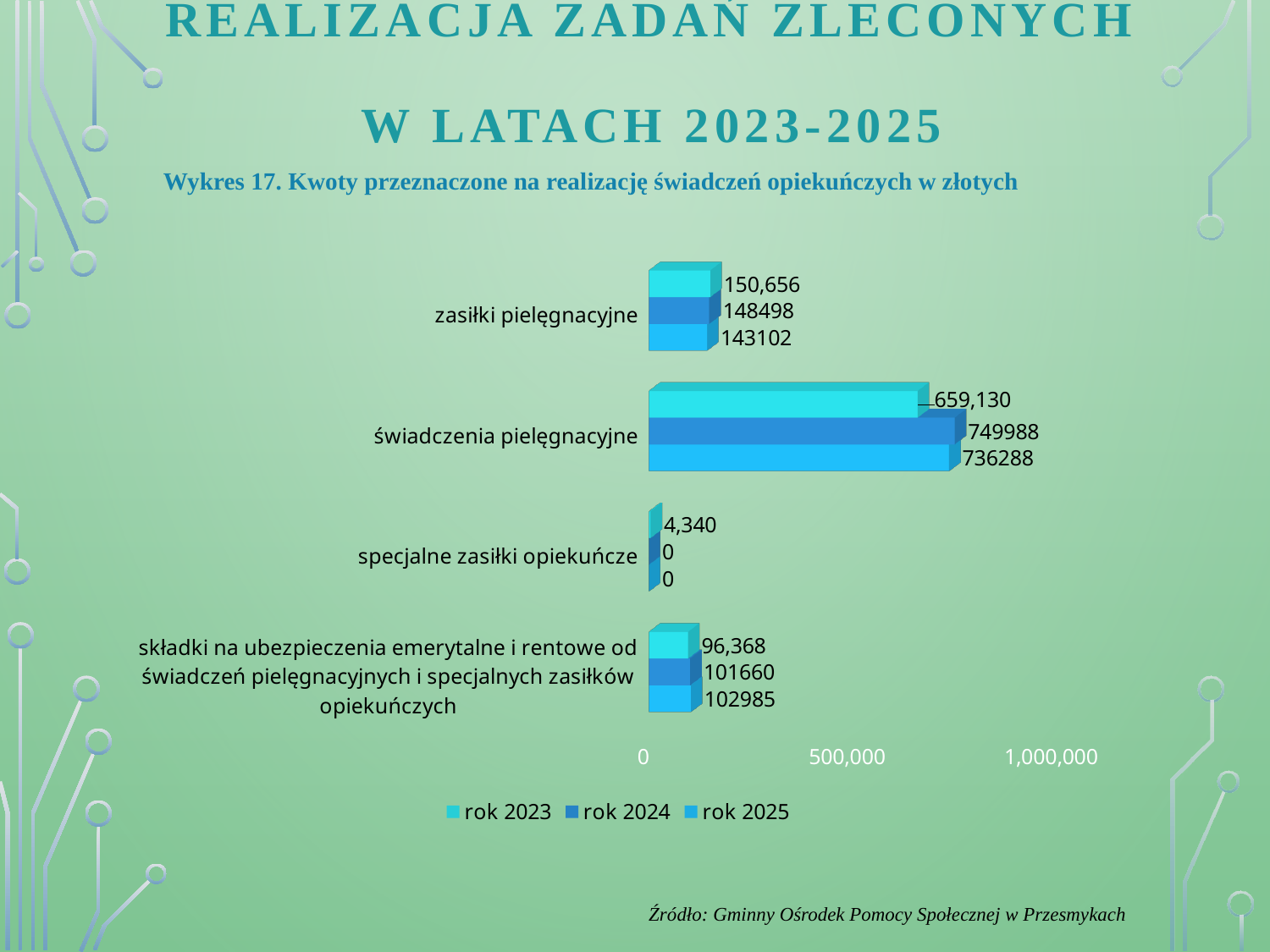
How many series does the legend list? 3 Which category has the lowest value in rok 2024? specjalne zasiłki opiekuńcze What is the title of the chart? Wykres 17. Kwoty przeznaczone na realizację świadczeń opiekuńczych w złotych Which is larger for zasiłki pielęgnacyjne: the rok 2023 value or the rok 2025 value? rok 2023 What kind of chart is shown on the slide? bar chart How many categories are shown on the chart? 4 What is the value for zasiłki pielęgnacyjne in rok 2023? 150,656 What is the value for składki na ubezpieczenia emerytalne i rentowe od świadczeń pielęgnacyjnych i specjalnych zasiłków opiekuńczych in rok 2025? 102985 What is the value for specjalne zasiłki opiekuńcze in rok 2023? 4,340 Which category has the highest value in rok 2025? świadczenia pielęgnacyjne What is the difference between the rok 2024 and rok 2025 values for świadczenia pielęgnacyjne? 13700 What is the value for świadczenia pielęgnacyjne in rok 2024? 749988